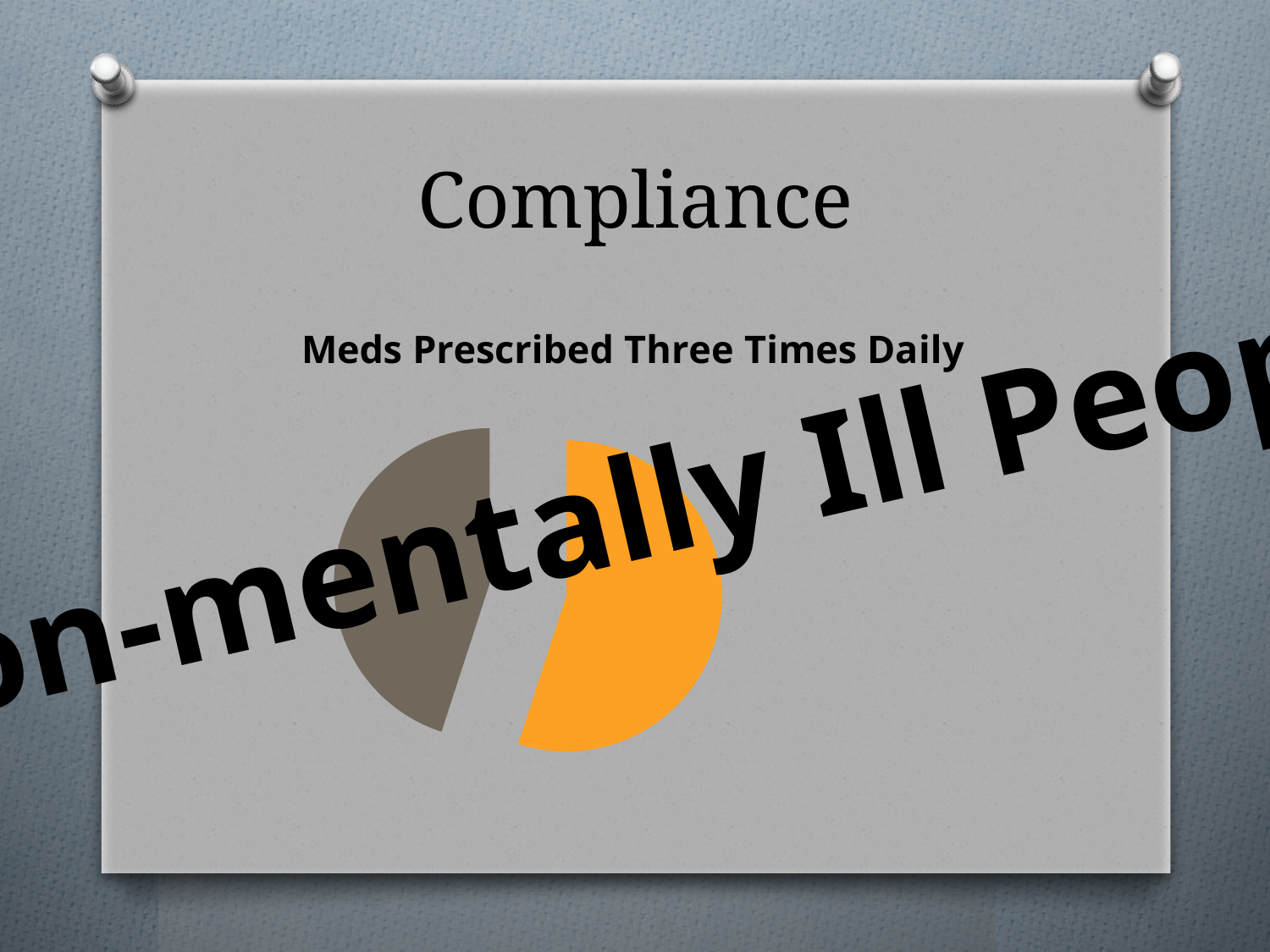
How many slices does the pie chart have? 2 Which slice takes up the largest share of the pie chart? The orange slice What kind of chart is shown on the slide? Pie chart Which slice of the pie chart is larger, the orange slice or the grey slice? The orange slice What is the title of the pie chart? Meds Prescribed Three Times Daily What two colours are used for the slices of the pie chart? Orange and grey